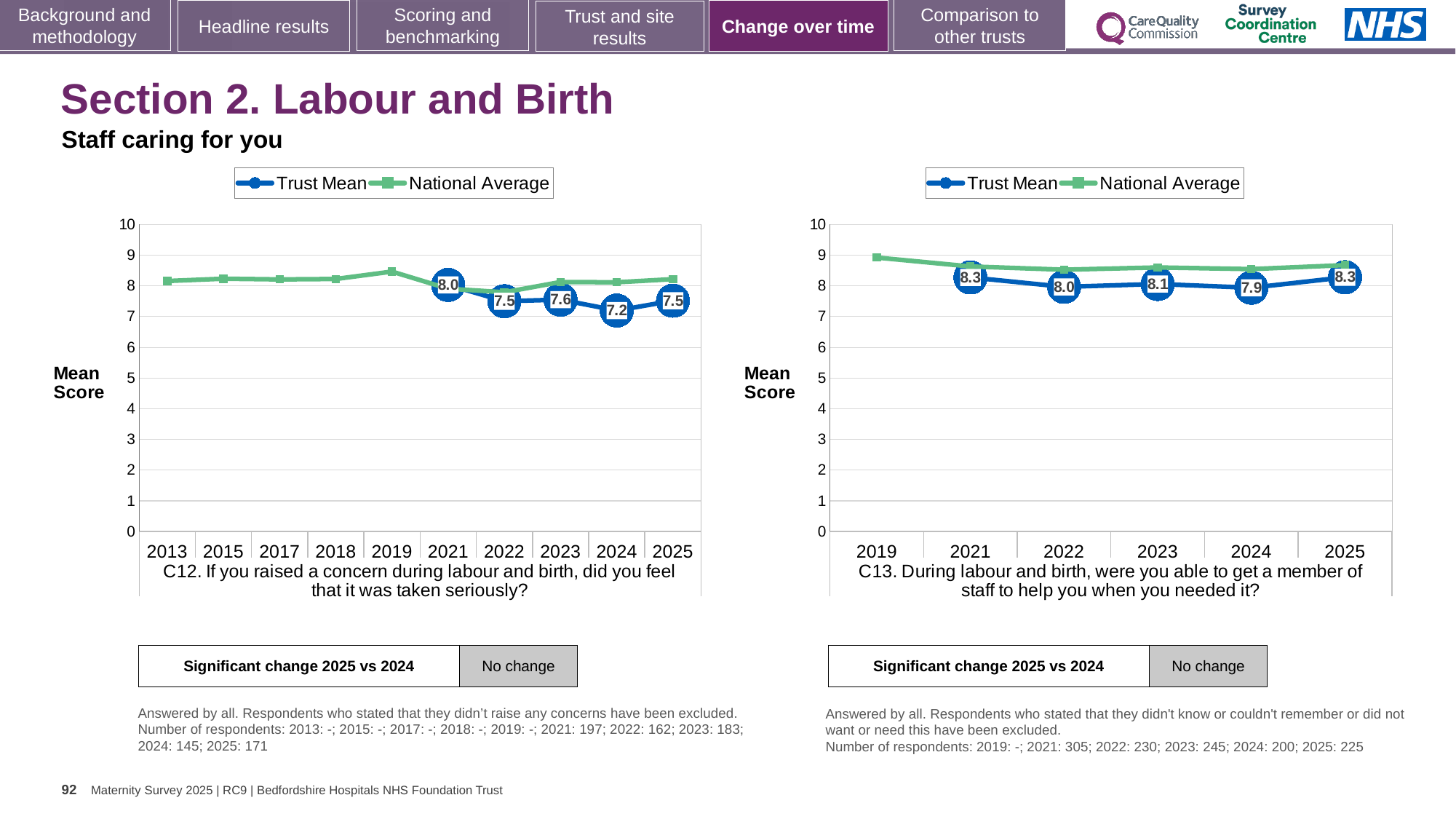
In the right chart (C13), is the Trust Mean value for 2023 larger or smaller than the value for 2024? larger In the left chart (C12), what is the Trust Mean value for 2021? 8.0 In the left chart (C12), which year has the lowest labelled Trust Mean value? 2024 In the left chart (C12), how many years are shown on the x axis? 10 What kind of chart is the left chart (C12)? line chart In the right chart (C13), which year has the lowest labelled Trust Mean value? 2024 In the left chart (C12), what is the Trust Mean value for 2024? 7.2 How many series does the legend of the right chart (C13) list? 2 In the right chart (C13), what is the Trust Mean value for 2022? 8.0 In the left chart (C12), what is the difference between the Trust Mean values for 2021 and 2024? 0.8 In the right chart (C13), is the National Average value for 2019 greater or less than 8? greater In the right chart (C13), what is the difference between the Trust Mean values for 2025 and 2024? 0.4